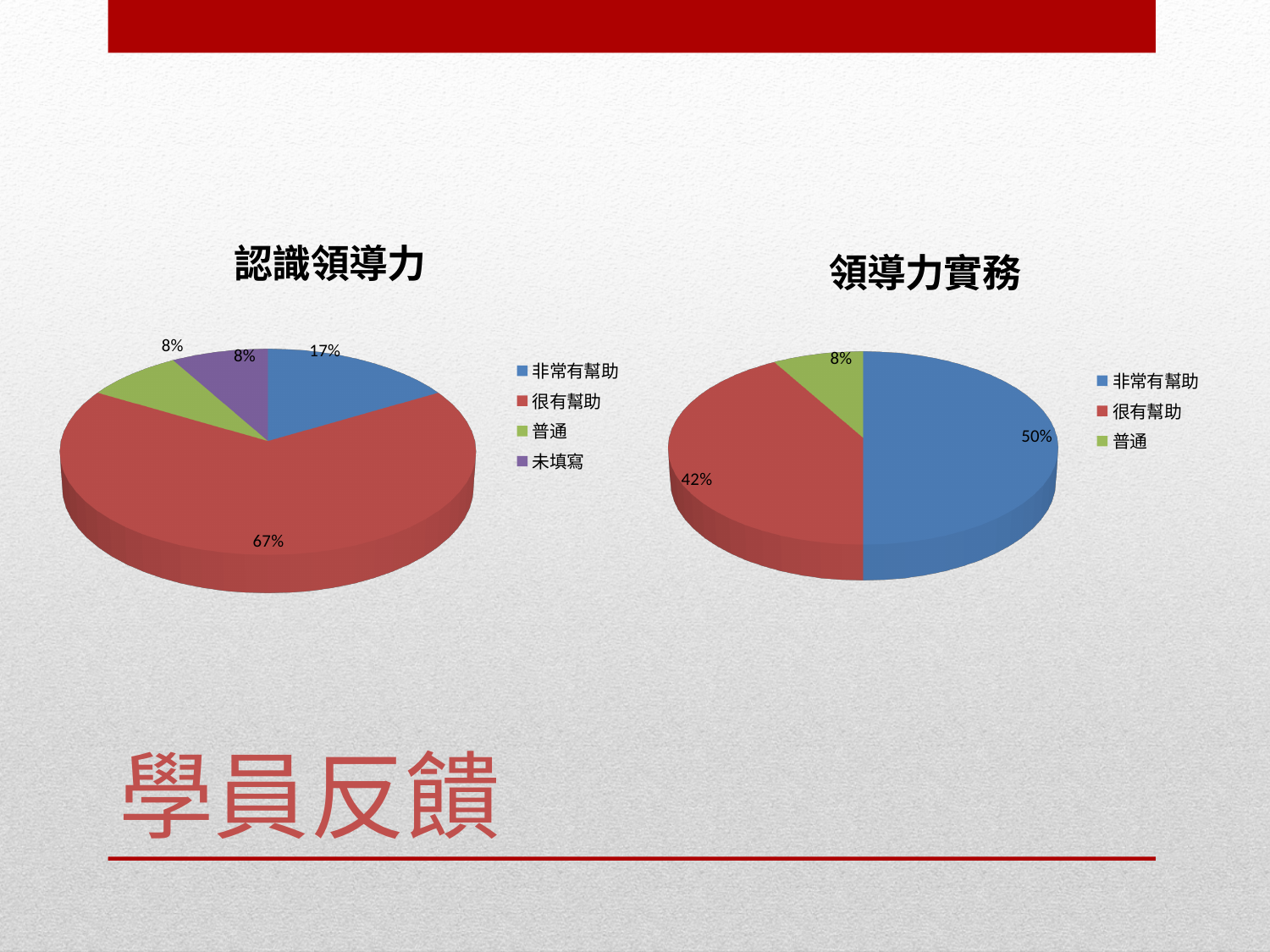
In the 領導力實務 chart, which category has the smallest share? 普通 In the 認識領導力 chart, which category is shown in purple? 未填寫 In the 領導力實務 chart, what is the difference between the shares of 非常有幫助 and 很有幫助? 8% In the 認識領導力 chart, which is larger, 非常有幫助 or 很有幫助? 很有幫助 How many categories does the legend of the 認識領導力 chart list? 4 In the 認識領導力 chart, which category has the largest share? 很有幫助 In the 認識領導力 chart, what share does 非常有幫助 have? 17% In the 領導力實務 chart, what share does 非常有幫助 have? 50% How many slices does the 領導力實務 chart have? 3 In the 領導力實務 chart, what share does 很有幫助 have? 42% What kind of chart is the 領導力實務 chart? Pie chart In the 認識領導力 chart, what share does 很有幫助 have? 67%